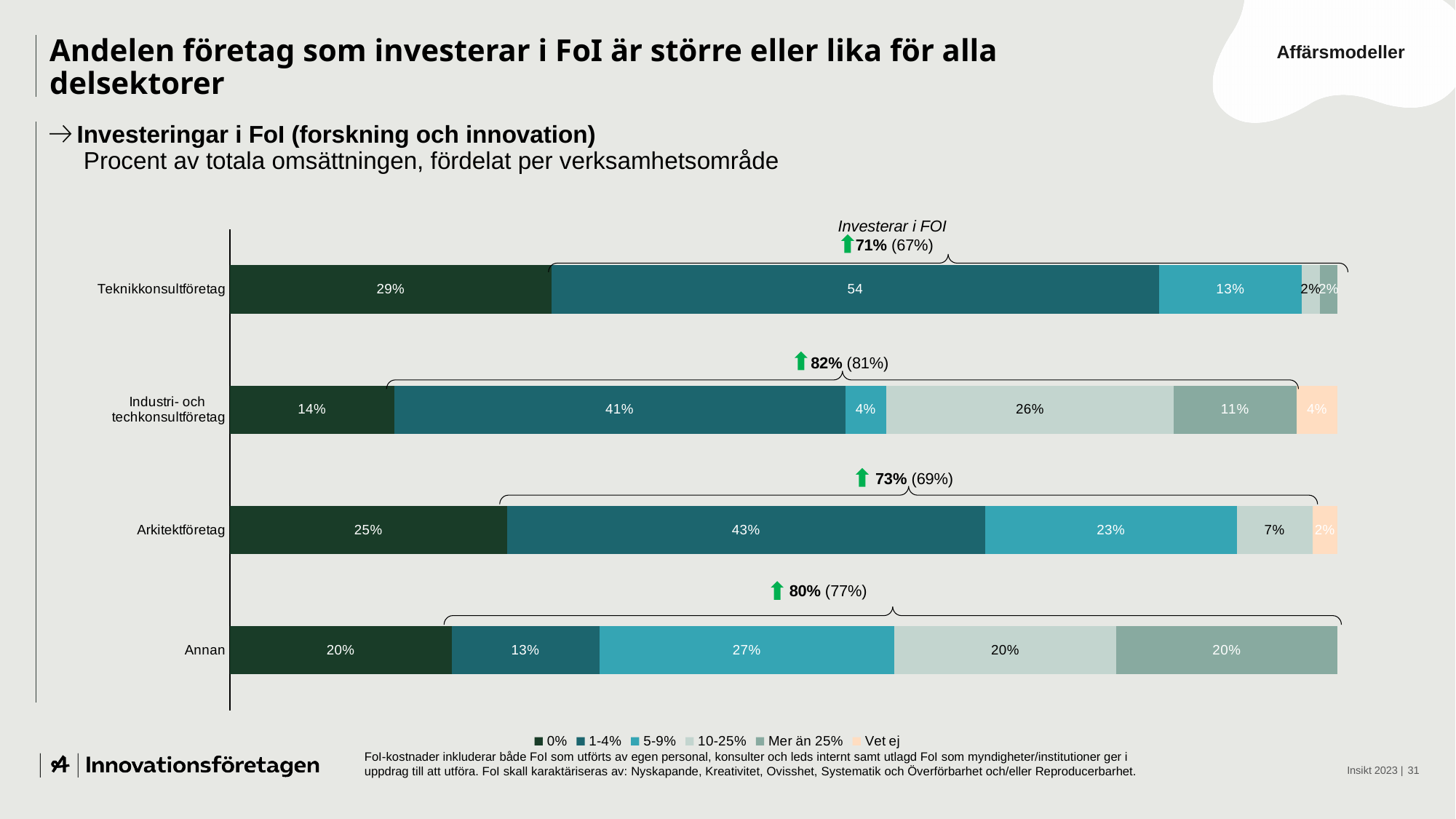
What kind of chart is shown on the slide? Stacked bar chart How many series does the legend list? 6 What is the value of the 10-25% segment for Annan? 20% Which sector has the smallest 0% segment? Industri- och techkonsultföretag What is the value of the 0% segment for Teknikkonsultföretag? 29% What is the difference between the 1-4% segments of Arkitektföretag and Annan? 30 percentage points How many categories (sectors) are shown on the chart? 4 What is the value of the 1-4% segment for Industri- och techkonsultföretag? 41% Which sector has the largest 0% segment? Teknikkonsultföretag What share of Industri- och techkonsultföretag is annotated as investing in FoI (Investerar i FOI)? 82% Which is larger: the 10-25% segment for Industri- och techkonsultföretag or for Arkitektföretag? Industri- och techkonsultföretag What is the value of the 5-9% segment for Arkitektföretag? 23%